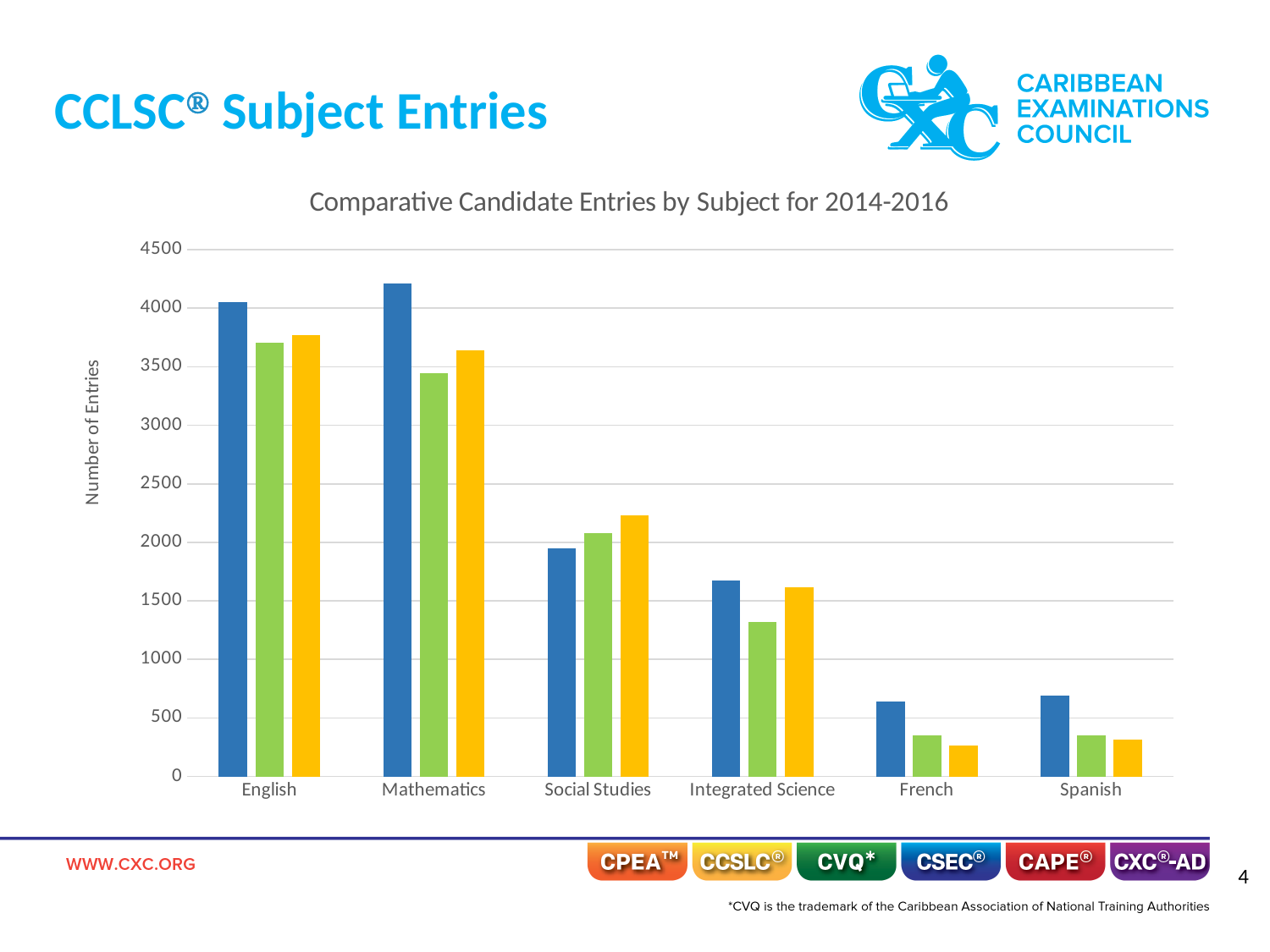
Is the blue bar for Mathematics greater or less than 4000? greater For Integrated Science, which is taller: the blue bar or the green bar? the blue bar How many bars are shown for each subject in the chart? 3 How many subjects are shown on the x axis of the chart? 6 What is the title of the chart? Comparative Candidate Entries by Subject for 2014-2016 Is the green bar for English greater or less than 4000? less What type of chart is shown on the slide? Bar chart Which subject has the tallest blue bar? Mathematics For Social Studies, which is taller: the blue bar or the yellow bar? the yellow bar What is the label on the vertical axis of the chart? Number of Entries Is the yellow bar for Social Studies greater or less than 2000? greater